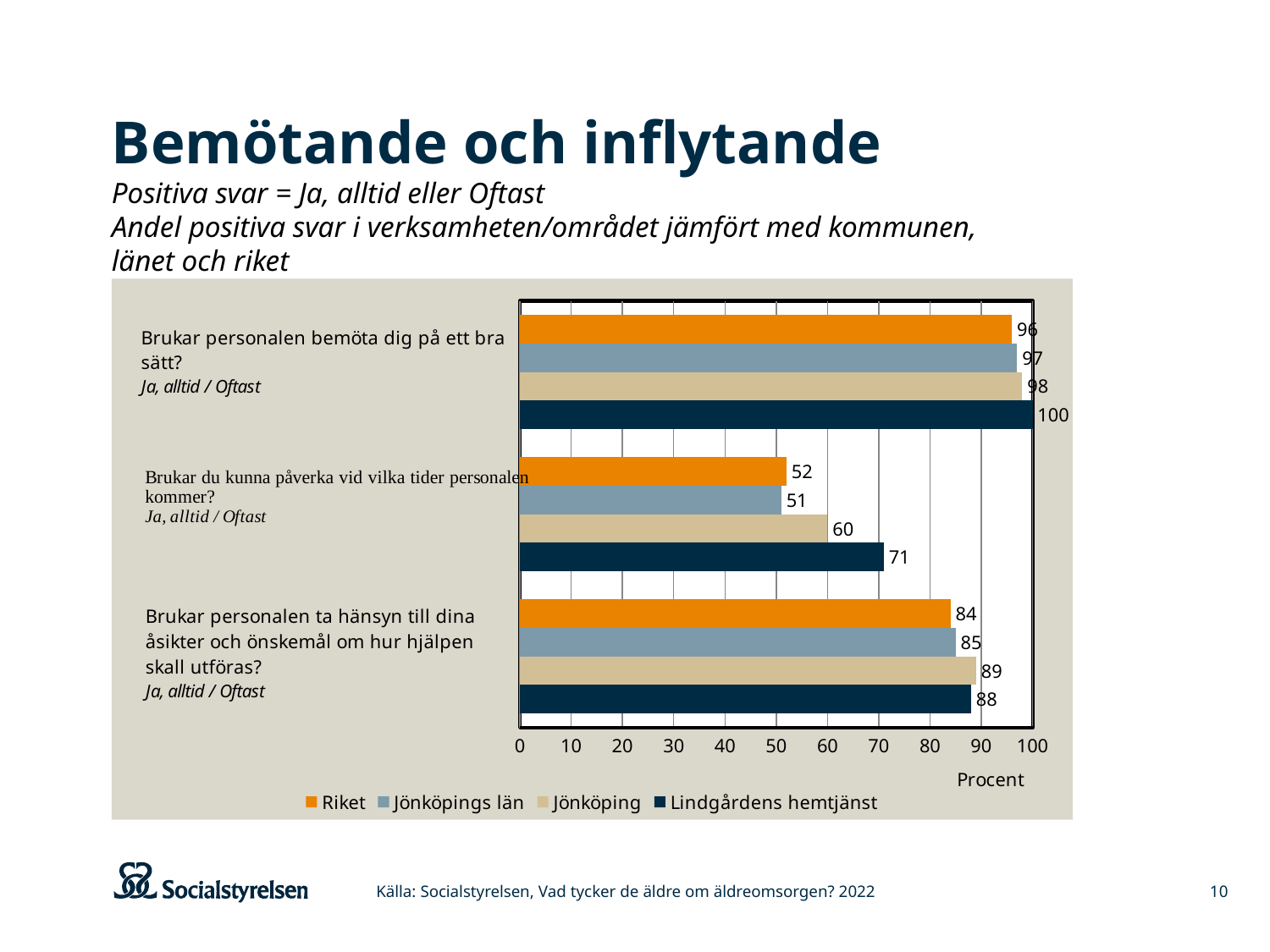
Which series has the highest value on the question "Brukar du kunna påverka vid vilka tider personalen kommer?"? Lindgårdens hemtjänst What is the label on the horizontal axis of the chart? Procent What is the value for Jönköping on the question "Brukar personalen ta hänsyn till dina åsikter och önskemål om hur hjälpen skall utföras?"? 89 How many series does the legend list? 4 What is the difference between Lindgårdens hemtjänst and Riket on the question "Brukar du kunna påverka vid vilka tider personalen kommer?"? 19 On the question "Brukar personalen ta hänsyn till dina åsikter och önskemål om hur hjälpen skall utföras?", which is larger: Jönköping or Lindgårdens hemtjänst? Jönköping What is the value for Riket on the question "Brukar personalen bemöta dig på ett bra sätt?"? 96 What is the value for Lindgårdens hemtjänst on the question "Brukar du kunna påverka vid vilka tider personalen kommer?"? 71 Which series has the lowest value on the question "Brukar personalen ta hänsyn till dina åsikter och önskemål om hur hjälpen skall utföras?"? Riket What is the value for Jönköpings län on the question "Brukar du kunna påverka vid vilka tider personalen kommer?"? 51 What kind of chart is shown on the slide? Bar chart How many questions (categories) are shown on the chart? 3